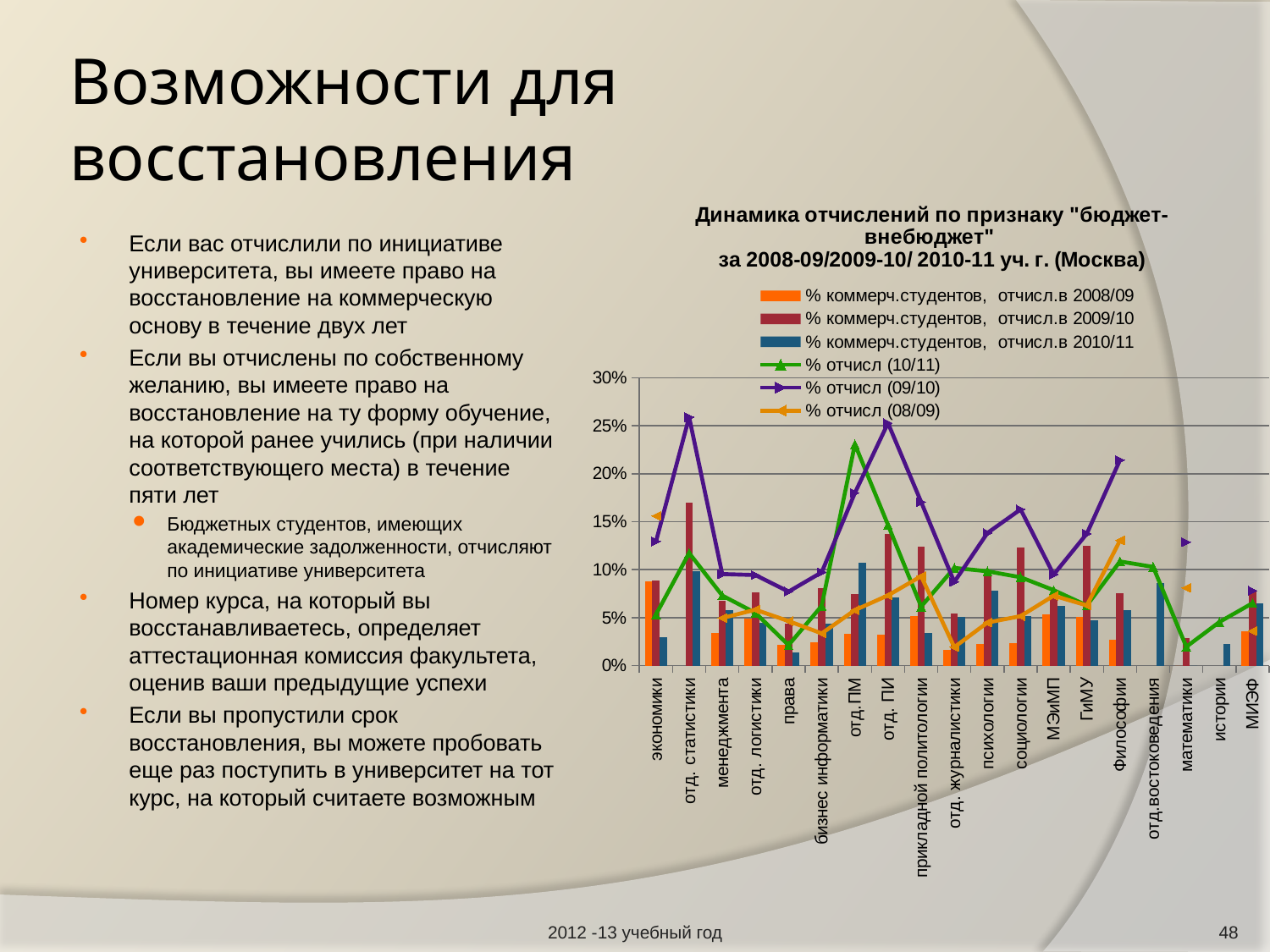
What colour are the bars for "% коммерч.студентов, отчисл.в 2008/09"? Orange Is the value of "% отчисл (09/10)" for отд. ПИ greater or less than 20%? greater Is the value of "% отчисл (09/10)" for отд. статистики greater or less than 20%? greater What kind of chart is shown on the slide? A combined bar and line chart How many categories (departments) are shown along the x axis of the chart? 19 Which category has the highest bar for "% коммерч.студентов, отчисл.в 2009/10"? отд. статистики Is the value of "% отчисл (10/11)" for отд.ПМ greater or less than 20%? greater Which is larger, the "% отчисл (09/10)" value for экономики or for менеджмента? экономики How many series does the chart legend list? 6 Which academic years does the chart title say the data covers? 2008-09/2009-10/2010-11